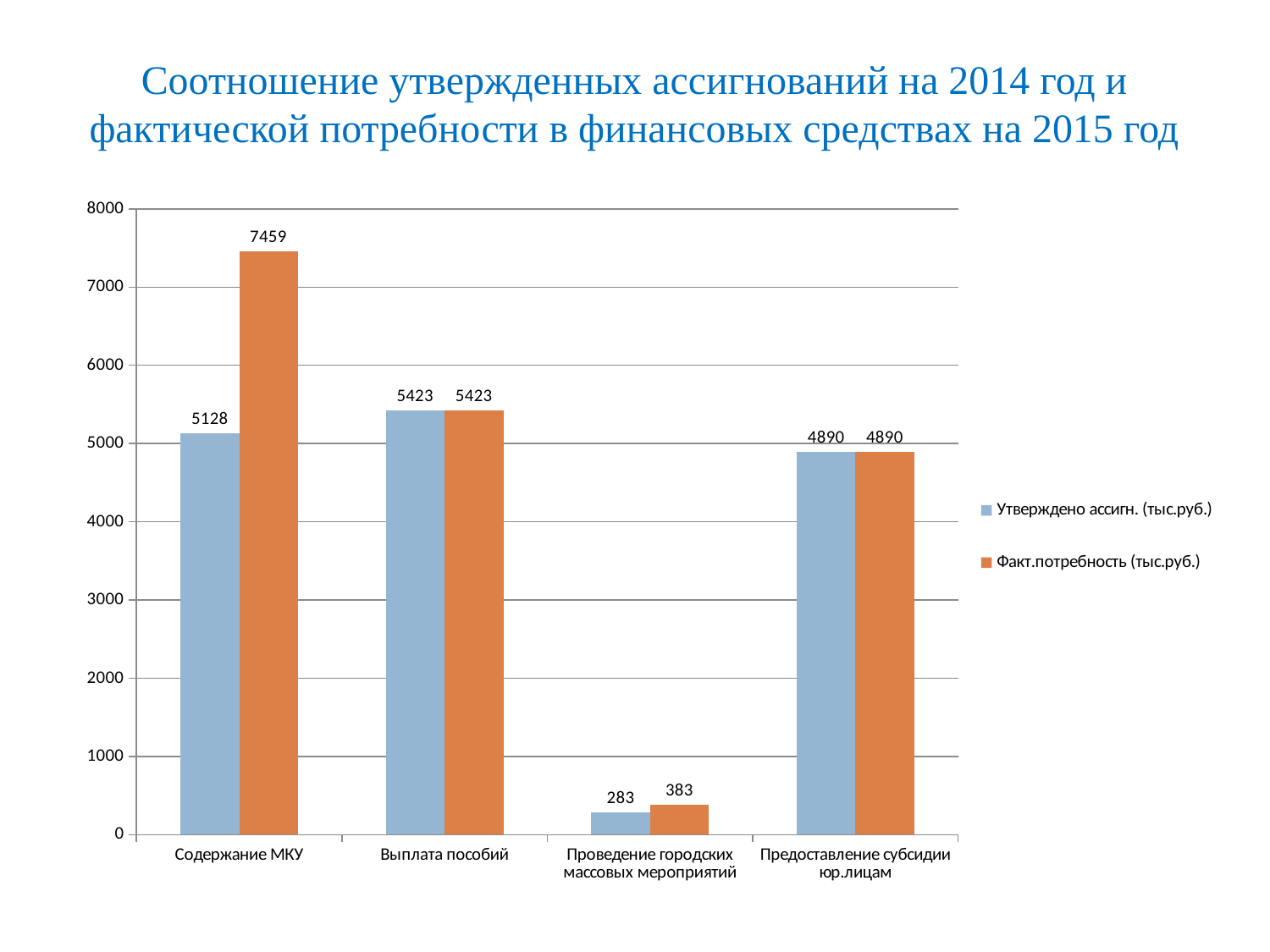
What is the difference between Факт.потребность and Утверждено ассигн. for Содержание МКУ? 2331 Which category has the lowest value for Утверждено ассигн. (тыс.руб.)? Проведение городских массовых мероприятий What is the value of Утверждено ассигн. (тыс.руб.) for Содержание МКУ? 5128 What is the value of Факт.потребность (тыс.руб.) for Содержание МКУ? 7459 How many series does the legend list? 2 How many categories are shown on the x axis? 4 What is the value of Утверждено ассигн. (тыс.руб.) for Предоставление субсидии юр.лицам? 4890 Which is larger for Выплата пособий: Утверждено ассигн. or Факт.потребность? They are equal (5423) Which category has the highest value for Факт.потребность (тыс.руб.)? Содержание МКУ What is the value of Факт.потребность (тыс.руб.) for Проведение городских массовых мероприятий? 383 What kind of chart is shown on the slide? Bar chart What is the difference between Факт.потребность and Утверждено ассигн. for Проведение городских массовых мероприятий? 100